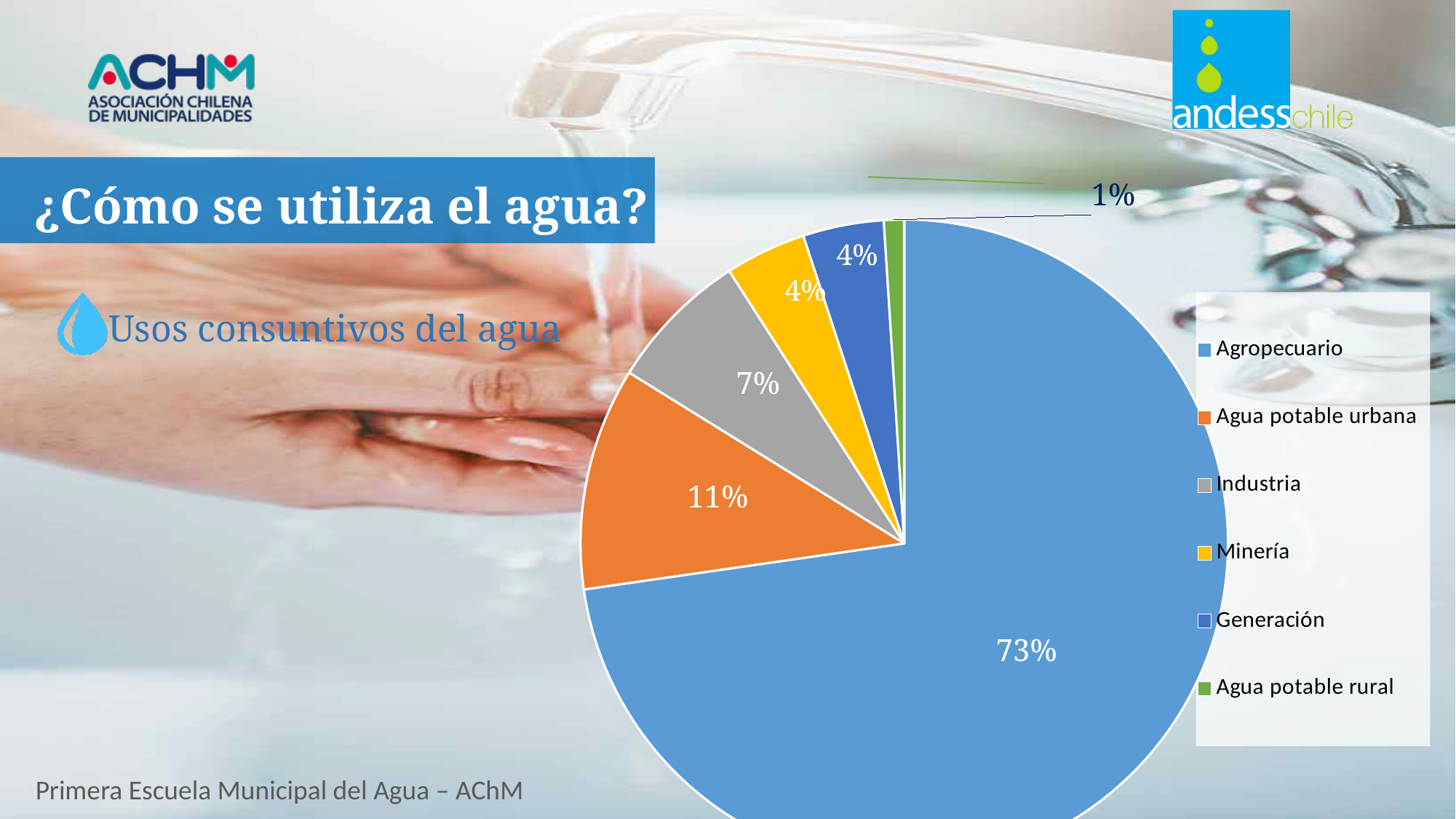
Which category has the largest slice of the pie? Agropecuario What is the value shown for Agua potable urbana? 11% What share of the pie does Agropecuario represent? 73% What kind of chart is shown on the slide? pie chart Which category has the smallest slice of the pie? Agua potable rural What is the value shown for Minería? 4% Which is larger, the share for Industria or the share for Minería? Industria How many categories does the legend list? 6 What colour is the slice for Minería? yellow What is the difference between the Agropecuario and Agua potable urbana shares? 62% What is the value shown for Agua potable rural? 1% What is the value shown for Industria? 7%